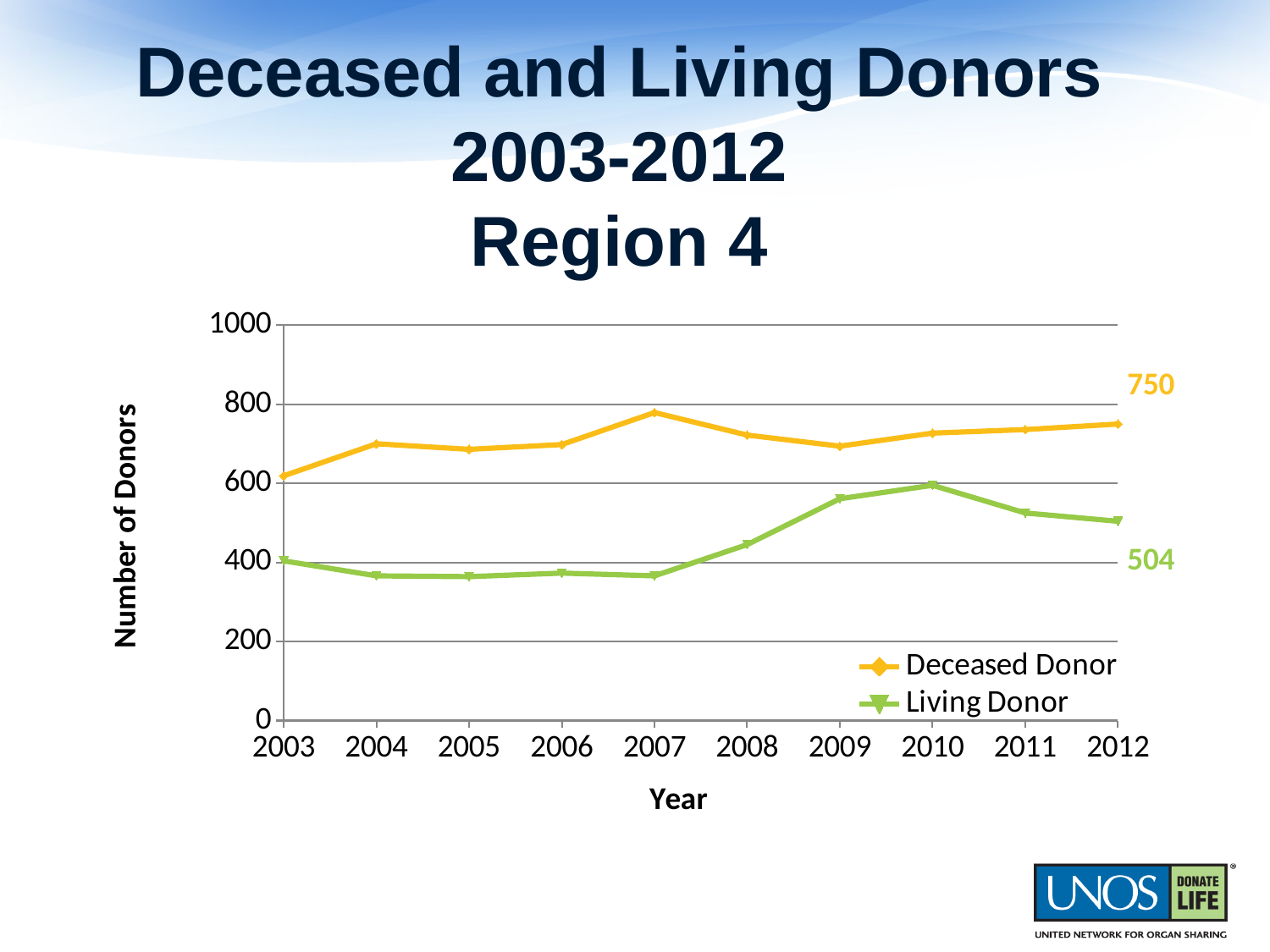
Is the value for Living Donor in 2009 greater or less than 400? greater How many series does the legend list? 2 Does the Living Donor line rise or fall from 2010 to 2012? fall What is the difference between the Deceased Donor and Living Donor values in 2012? 246 What kind of chart is shown on the slide? line chart How many years are shown on the x axis? 10 Is the value for Deceased Donor in 2007 greater or less than 600? greater What is the value for Living Donor in 2012? 504 In 2012, which series has the larger value, Deceased Donor or Living Donor? Deceased Donor What is the label on the y axis? Number of Donors Is the value for Living Donor in 2005 greater or less than 400? less What is the value for Deceased Donor in 2012? 750